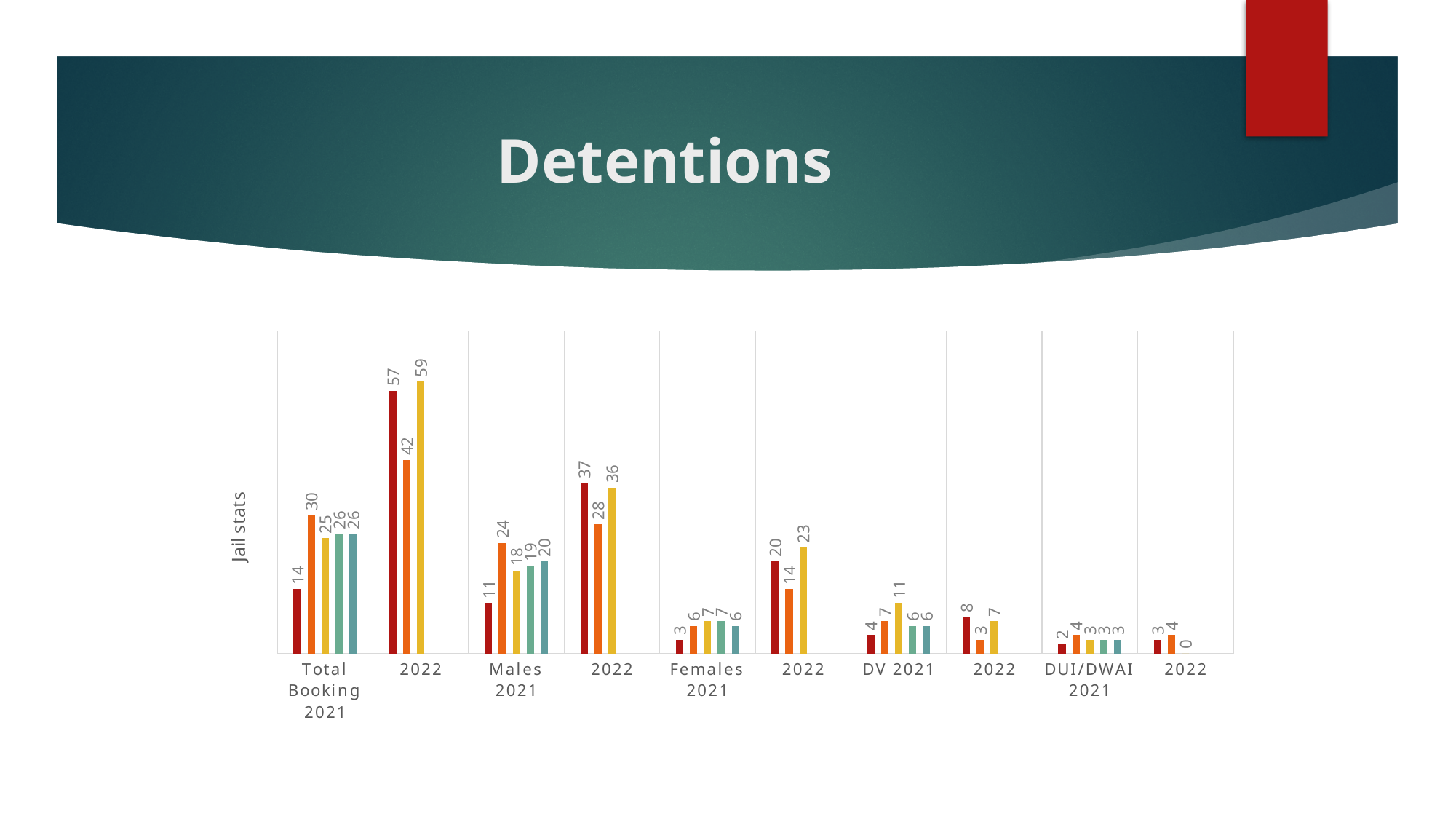
What is the value of the yellow bar for DV 2021? 11 What is the value of the yellow bar in the 2022 group next to DUI/DWAI 2021? 0 What is the value of the first (dark red) bar for Total Booking 2021? 14 Which bar in the whole chart has the highest value? the yellow bar for 2022 next to Total Booking 2021 (59) What is the value of the dark red bar in the 2022 group next to Males 2021? 37 What is the value of the orange bar for Males 2021? 24 How many categories are shown along the x axis of the chart? 10 What is the value of the yellow bar in the 2022 group next to Total Booking 2021? 59 What kind of chart is shown on the slide? bar chart Which is larger: the dark red bar for Males 2021 or the orange bar for Males 2021? the orange bar (24) What is the label on the vertical axis of the chart? Jail stats What is the difference between the yellow bar (59) and the orange bar (42) in the 2022 group next to Total Booking 2021? 17